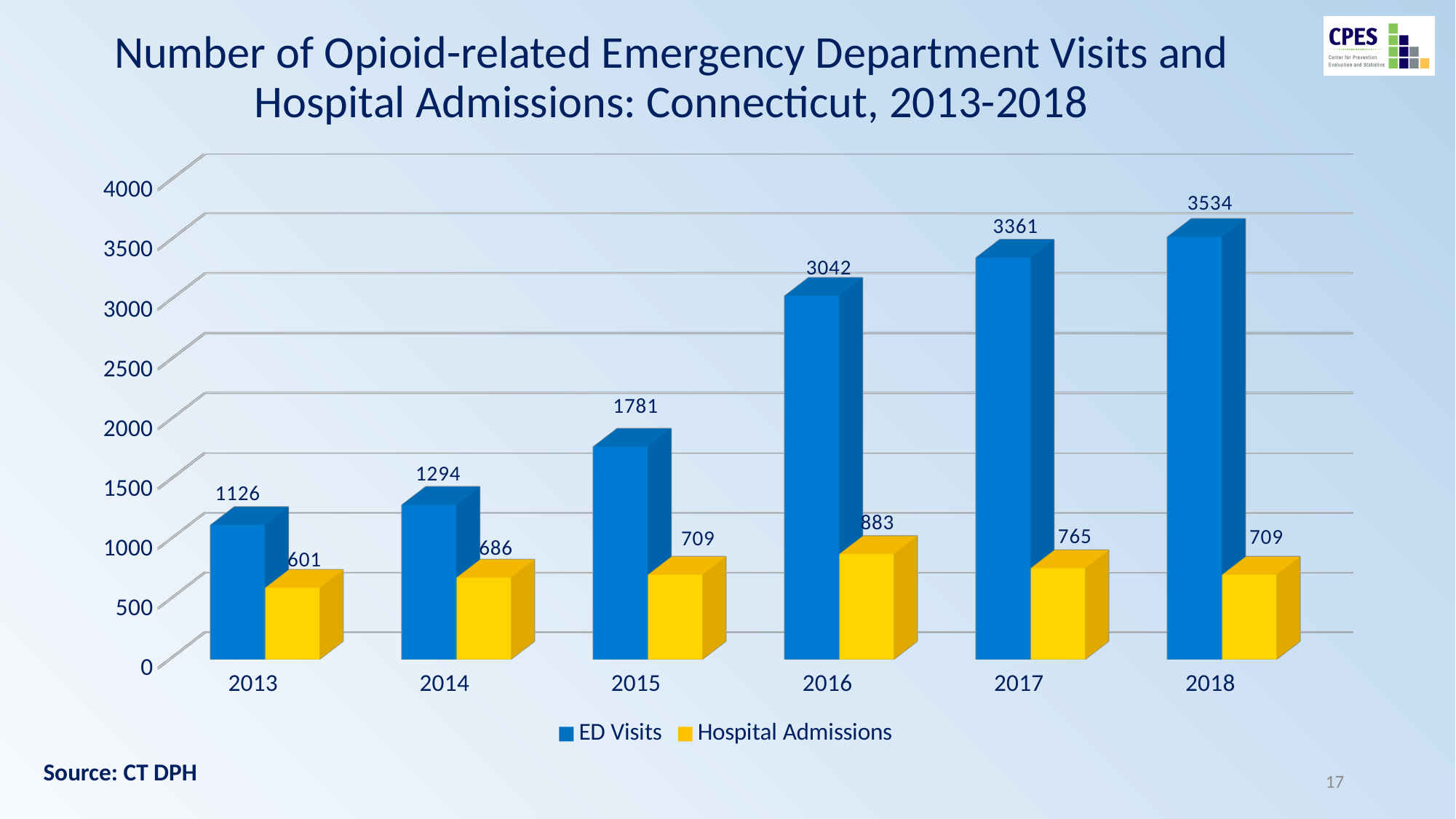
Which year had the highest number of ED Visits? 2018 What kind of chart is shown on the slide? Bar chart What is the difference between ED Visits in 2018 and ED Visits in 2013? 2408 How many series does the legend list? 2 What was the number of ED Visits in 2016? 3042 Which is larger: ED Visits in 2015 or ED Visits in 2014? ED Visits in 2015 What is the difference between Hospital Admissions in 2016 and Hospital Admissions in 2017? 118 What was the number of Hospital Admissions in 2013? 601 Which year had the lowest number of Hospital Admissions? 2013 Which year had the highest number of Hospital Admissions? 2016 How many years are shown on the x axis? 6 Do ED Visits rise or fall from 2013 to 2018? Rise